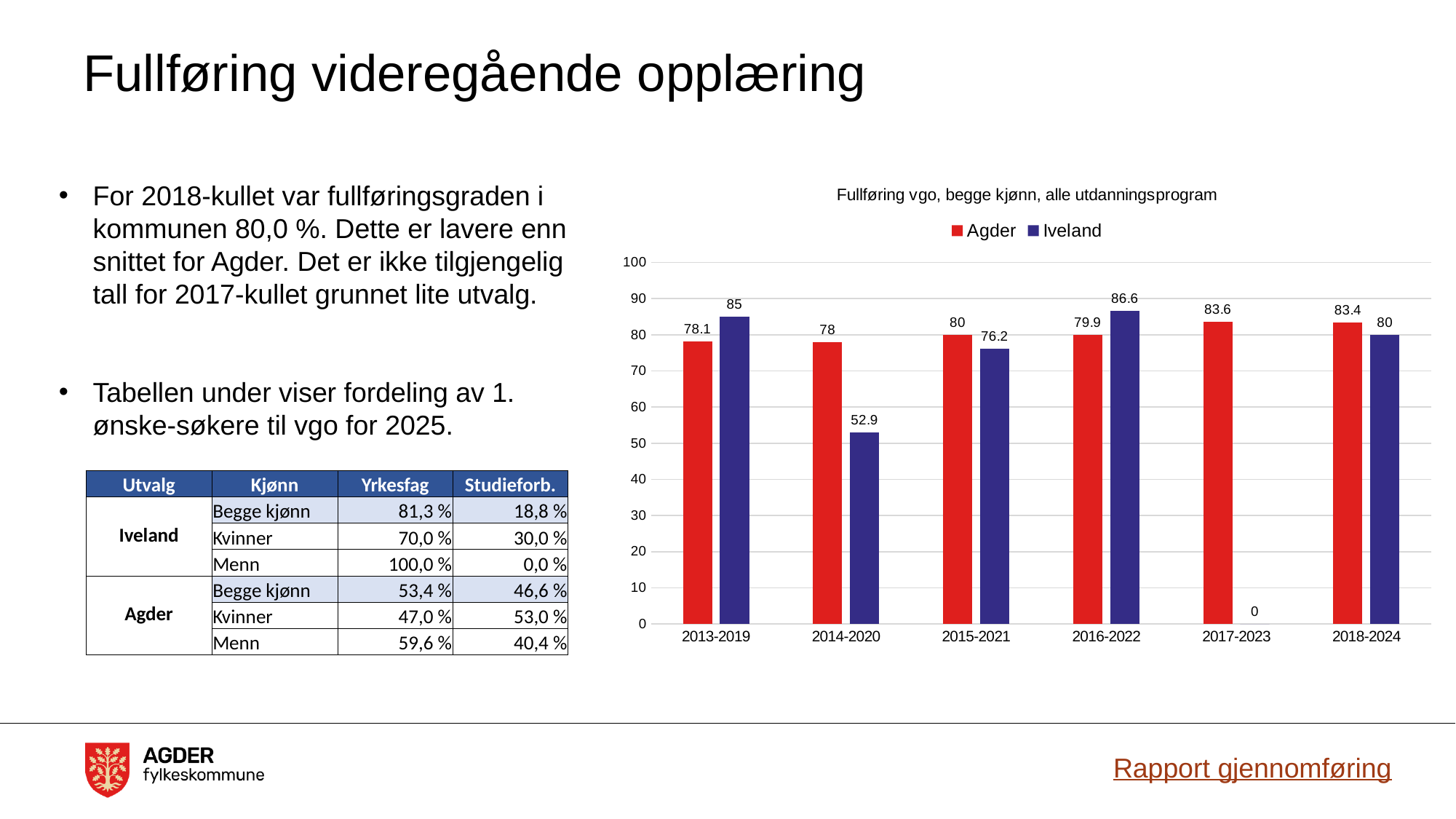
What kind of chart is shown? Bar chart What is the difference between the Iveland and Agder values in 2014-2020? 25.1 What is the value for Iveland in 2016-2022? 86.6 Which period has the highest value for Iveland? 2016-2022 What is the title of the chart? Fullføring vgo, begge kjønn, alle utdanningsprogram Which period has the lowest value for Agder? 2014-2020 What is the value for Agder in 2018-2024? 83.4 Which is larger in 2015-2021, Agder or Iveland? Agder What is the value for Iveland in 2014-2020? 52.9 What is the value for Agder in 2013-2019? 78.1 How many periods are shown on the x axis? 6 How many series does the legend list? 2